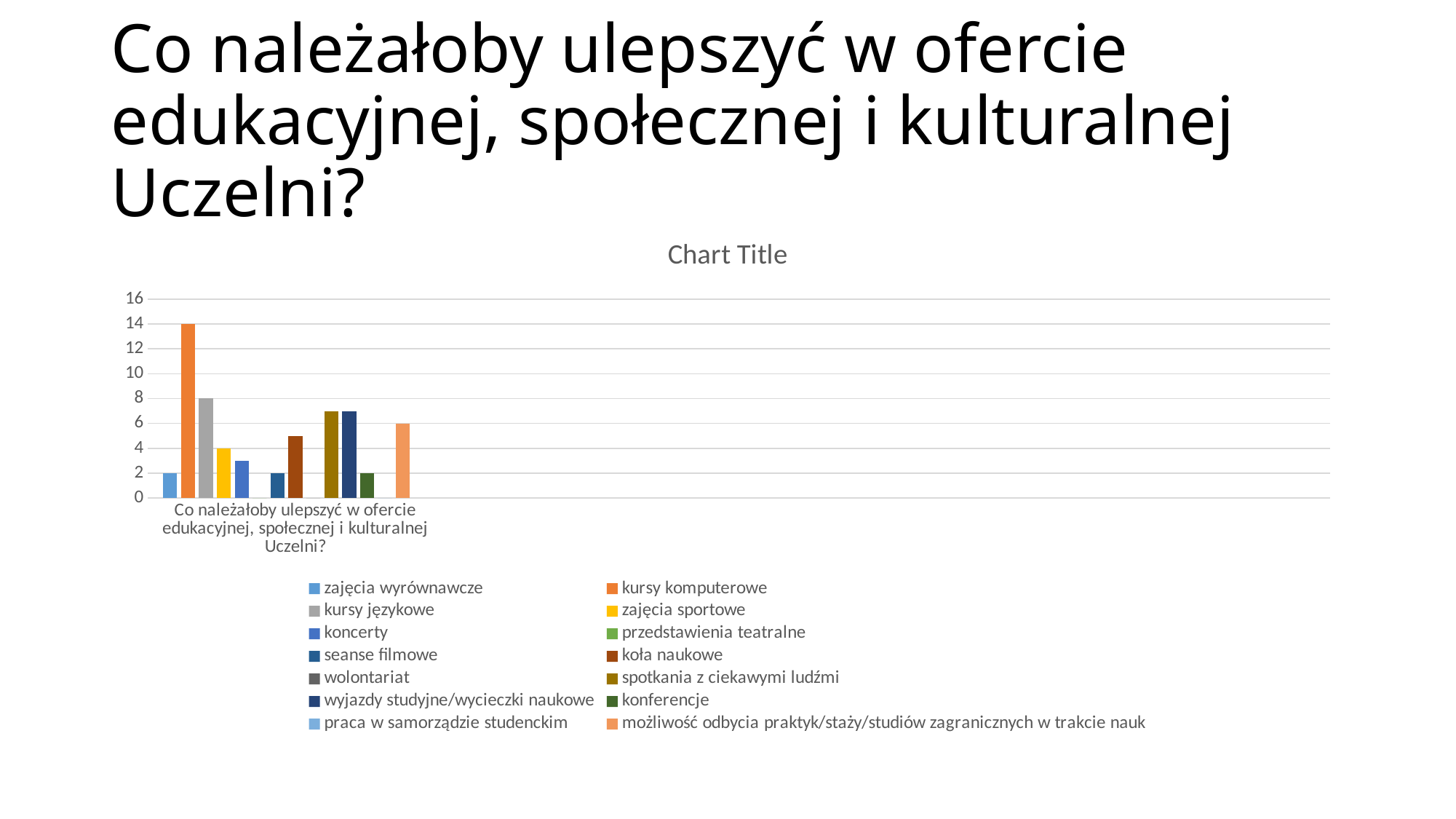
What is the value for możliwość odbycia praktyk/staży/studiów zagranicznych w trakcie nauk? 6 What is the value for kursy komputerowe? 14 Which series has the highest bar? kursy komputerowe What is the title shown above the chart? Chart Title Is the value for koła naukowe greater or less than 4? greater What is the difference between the values for kursy komputerowe and kursy językowe? 6 What is the value for zajęcia sportowe? 4 How many series does the legend list? 14 What is the value for kursy językowe? 8 How many categories are shown on the x axis? 1 Which is larger, the value for kursy językowe or the value for zajęcia sportowe? kursy językowe What kind of chart is shown on the slide? bar chart